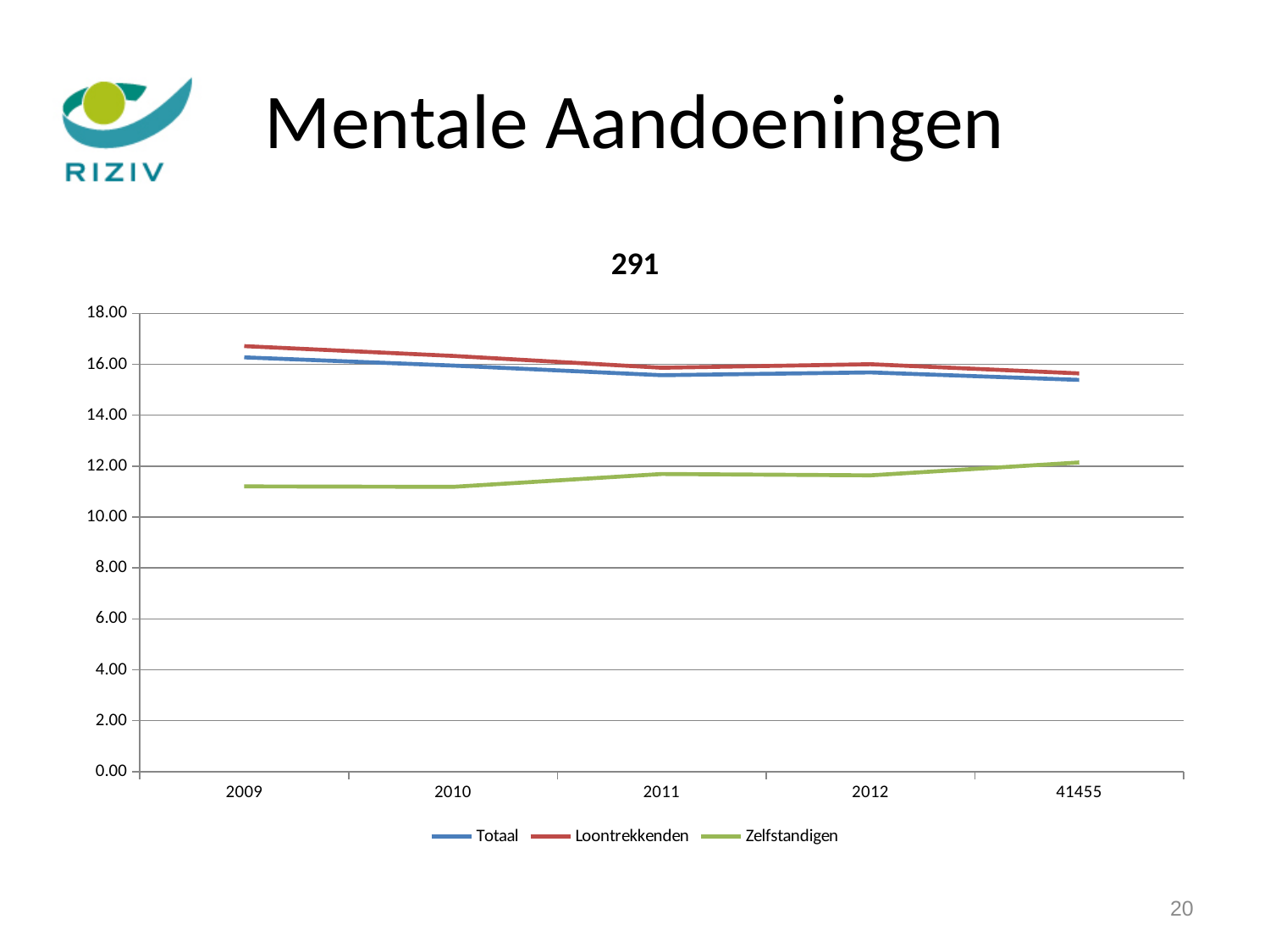
Is the value for Loontrekkenden in 2009 greater or less than 16.00? greater What kind of chart is shown on the slide? line chart Does the Loontrekkenden series rise or fall from 2009 to 2011? fall Is the value for Totaal in 2012 greater or less than 14.00? greater What is the title of the chart? 291 How many series does the legend list? 3 Does the Zelfstandigen series rise or fall from 2009 to the last point on the x axis? rise Which series is drawn in green? Zelfstandigen At which x-axis point is the Loontrekkenden series highest? 2009 How many points are plotted along the x axis for each series? 5 In 2009, which is larger: the value for Loontrekkenden or the value for Zelfstandigen? Loontrekkenden Is the value for Zelfstandigen in 2009 greater or less than 12.00? less